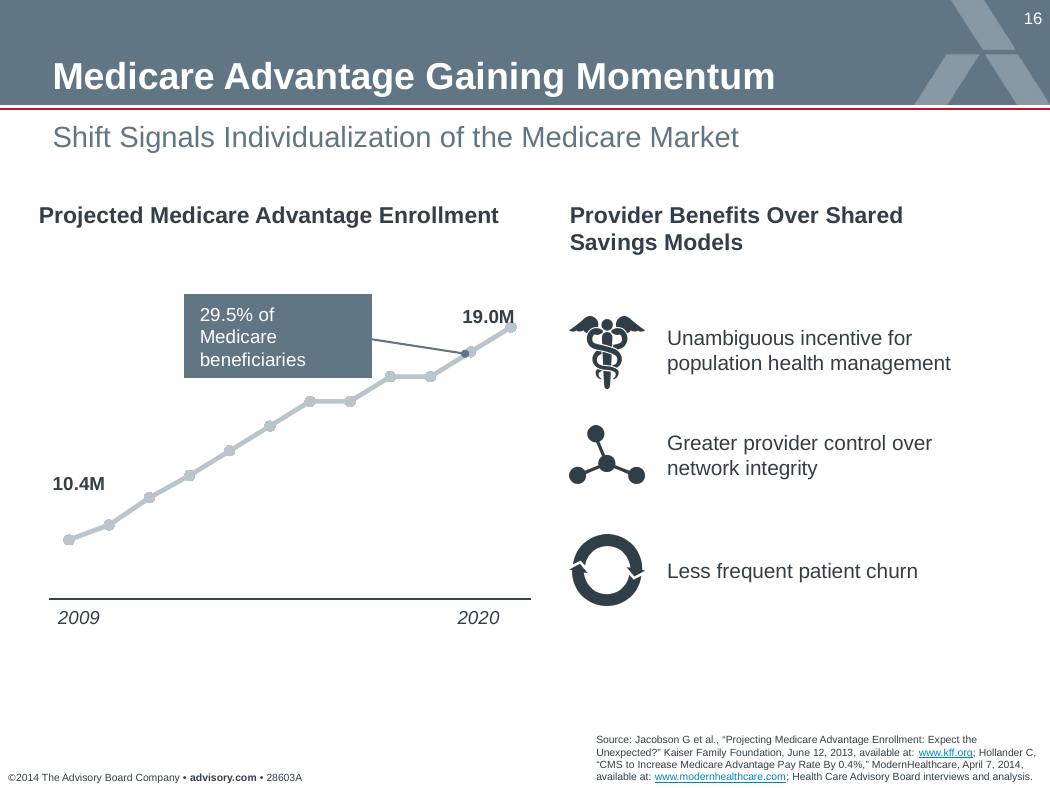
What is the projected Medicare Advantage enrollment value shown for 2009? 10.4M Which year has the lowest projected Medicare Advantage enrollment on the chart? 2009 What is the projected Medicare Advantage enrollment value shown for 2020? 19.0M Does projected Medicare Advantage enrollment rise or fall from 2009 to 2020? Rise By how much does projected Medicare Advantage enrollment grow from 2009 to 2020? 8.6M What share of Medicare beneficiaries does the callout on the chart say Medicare Advantage will reach? 29.5% How many data points are plotted on the Projected Medicare Advantage Enrollment line? 12 What is the title of the chart on the left side of the slide? Projected Medicare Advantage Enrollment Is projected Medicare Advantage enrollment larger in 2009 or in 2020? 2020 What are the first and last years labeled on the x axis of the enrollment chart? 2009 and 2020 Which year has the highest projected Medicare Advantage enrollment on the chart? 2020 What type of chart is used to show Projected Medicare Advantage Enrollment? Line chart